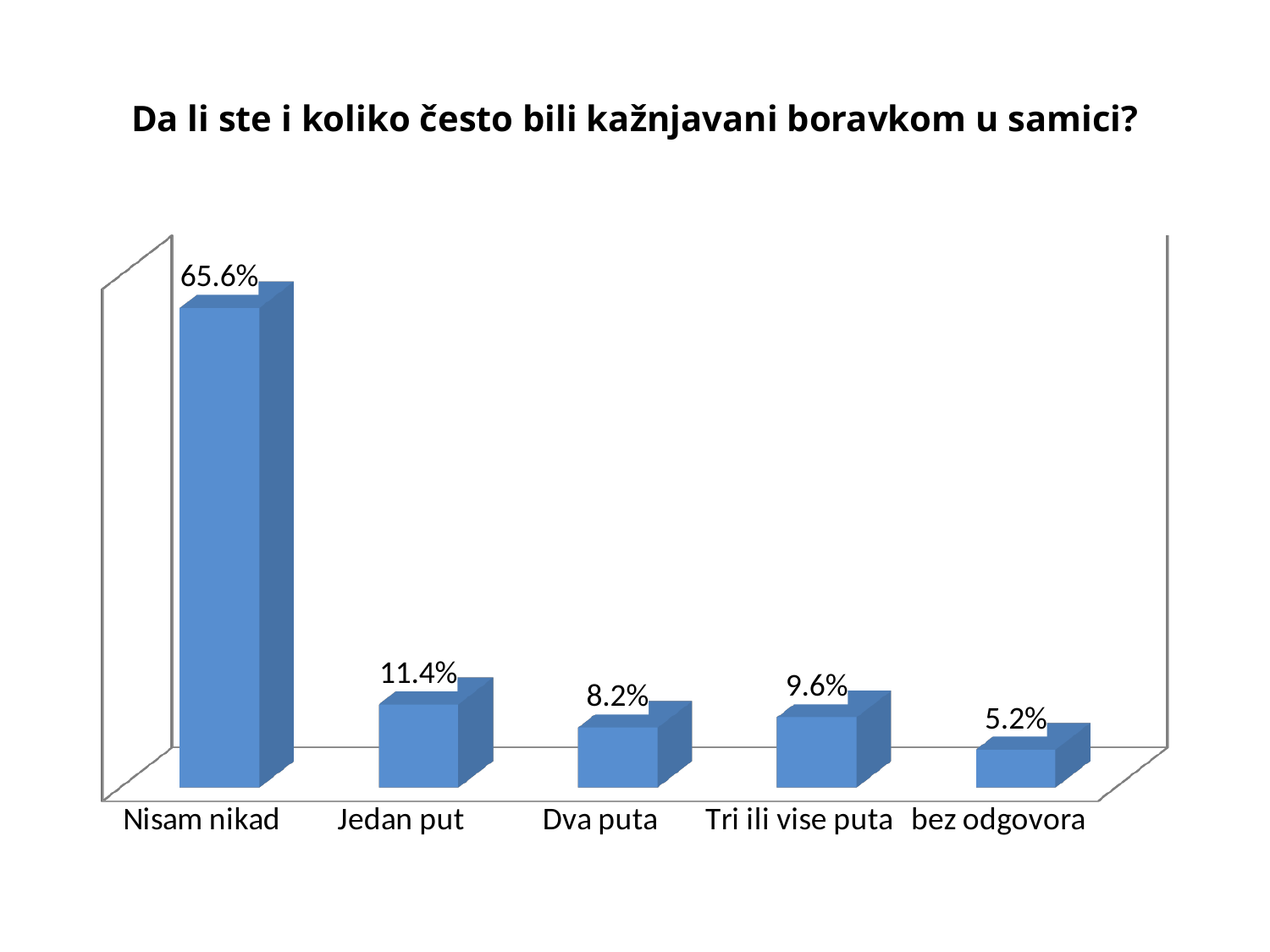
What is the value for "bez odgovora"? 5.2% Which is larger, the value for "Dva puta" or the value for "Tri ili vise puta"? Tri ili vise puta Which category has the highest value? Nisam nikad What is the difference between the values for "Nisam nikad" and "Jedan put"? 54.2% How many categories are shown on the x axis? 5 What is the title of the chart? Da li ste i koliko često bili kažnjavani boravkom u samici? What kind of chart is shown on the slide? Bar chart What is the value for "Nisam nikad"? 65.6% Which category has the lowest value? bez odgovora What is the value for "Dva puta"? 8.2% What is the value for "Jedan put"? 11.4% What is the value for "Tri ili vise puta"? 9.6%